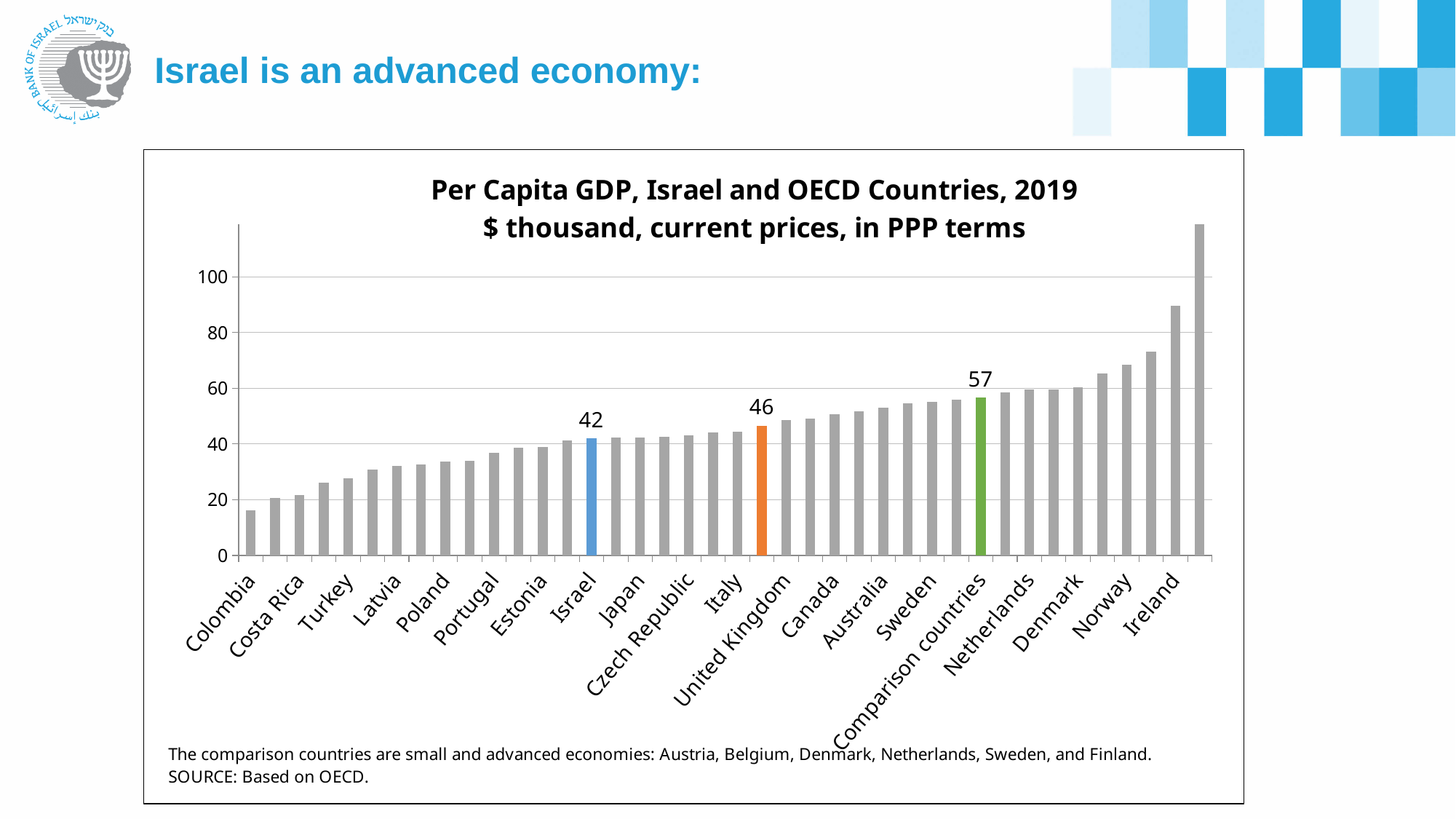
What is the per capita GDP value shown for Israel? 42 Which has a higher per capita GDP, Israel or Italy? Italy What is the value shown for the Comparison countries bar? 57 What kind of chart is shown on the slide? bar chart Is the value for Colombia greater or less than 20? less Which country has the lowest per capita GDP in the chart? Colombia Is the value for Ireland greater or less than 100? less What is the difference between the Comparison countries value and Israel's value? 15 Do the values rise or fall moving from left to right along the x axis? rise